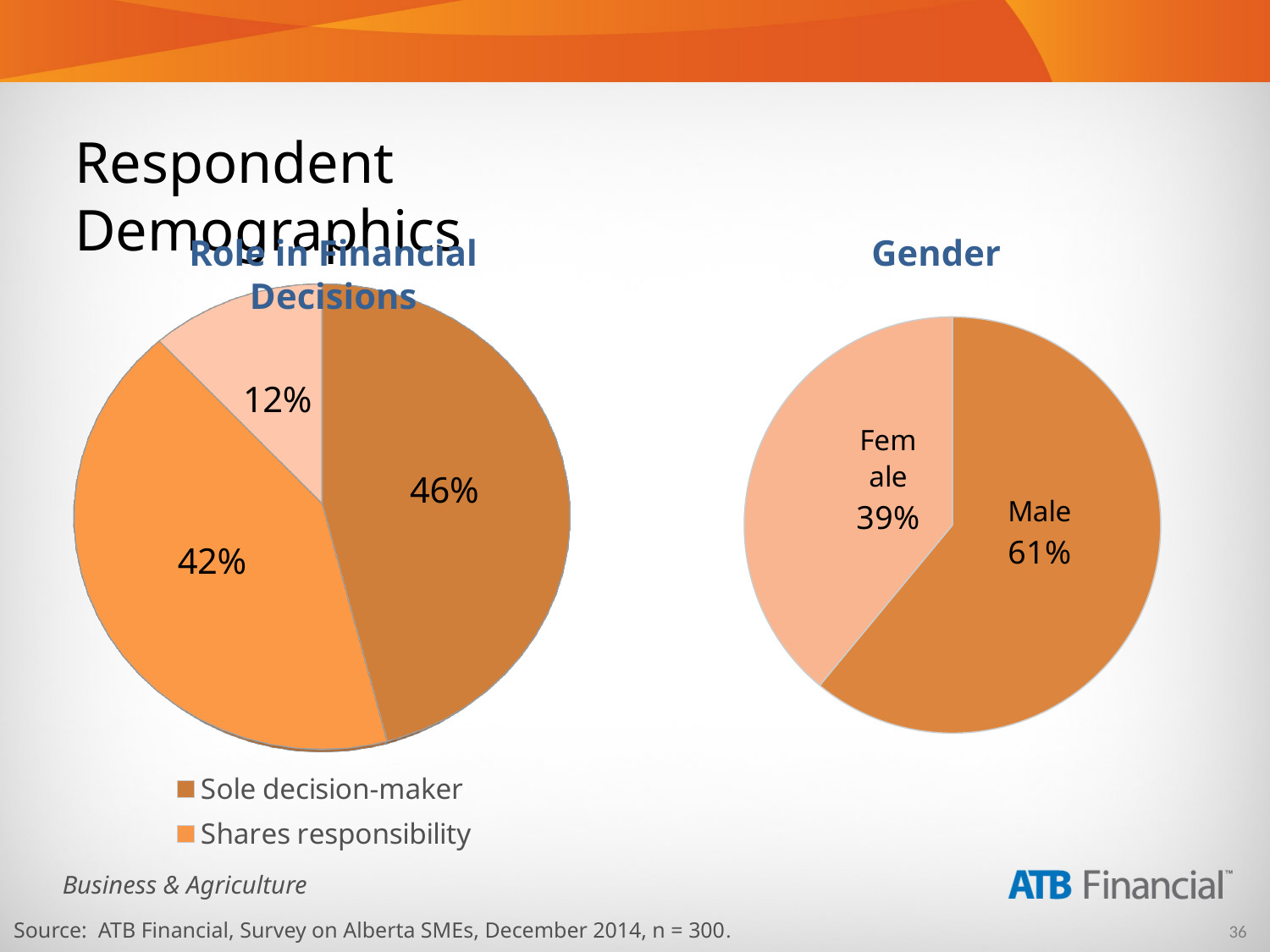
In the Role in Financial Decisions chart, what is the value of the smallest slice? 12% How many slices does the Role in Financial Decisions chart have? 3 In the Role in Financial Decisions chart, what is the difference in percentage points between Sole decision-maker and Shares responsibility? 4 In the Role in Financial Decisions chart, what share of respondents share responsibility? 42% In the Gender chart, what is the difference in percentage points between Male and Female? 22 How many slices does the Gender chart have? 2 In the Gender chart, which category has the larger share? Male In the Role in Financial Decisions chart, what share of respondents are sole decision-makers? 46% In the Gender chart, what percentage of respondents are Male? 61% What type of chart is the Gender chart? Pie chart In the Role in Financial Decisions chart, which is larger: Sole decision-maker or Shares responsibility? Sole decision-maker In the Gender chart, what percentage of respondents are Female? 39%